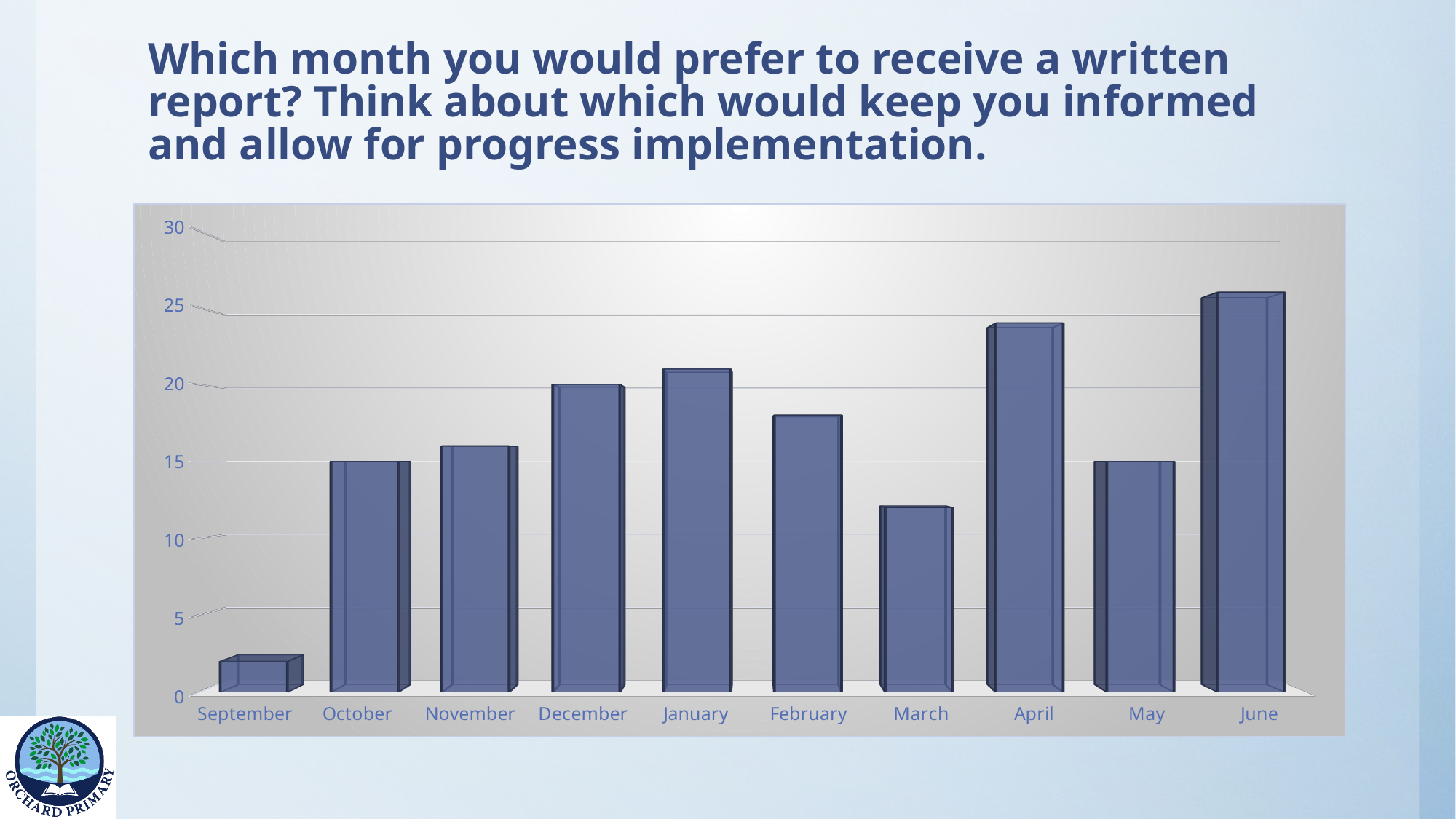
What is the highest value shown on the vertical axis of the chart? 30 Is the value for February greater or less than 15? greater Which has the larger value, December or October? December How many months are shown on the x axis of the chart? 10 Which month has the lowest bar in the chart? September Which month has the highest bar in the chart? June Which has the larger value, April or March? April Is the value for March greater or less than 15? less Do the values rise or fall from September through January? rise Is the value for April greater or less than 20? greater What kind of chart is shown on the slide? bar chart